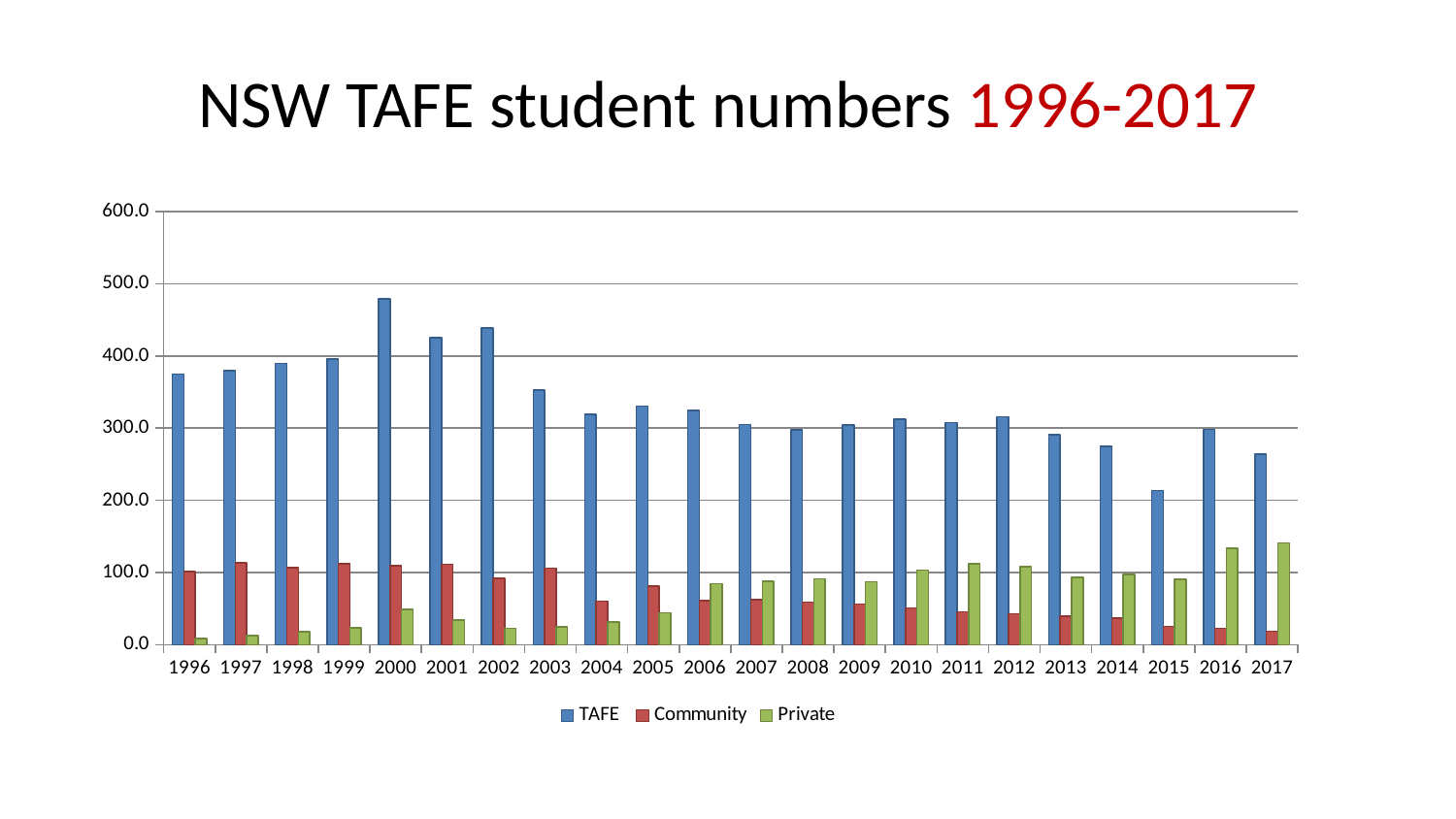
Do the Private values generally rise or fall from 1996 to 2017? rise Which is larger, the TAFE value for 1996 or the TAFE value for 2017? 1996 How many years are shown along the x axis? 22 In which year is the Private value highest? 2017 Is the TAFE value for 2000 greater or less than 400.0? greater What are the three series named in the legend? TAFE, Community, Private In which year is the TAFE value highest? 2000 Is the TAFE value for 2015 greater or less than 300.0? less What kind of chart is shown on the slide? bar chart How many series does the legend list? 3 In which year is the TAFE value lowest? 2015 Is the Private value for 2017 greater or less than 100.0? greater